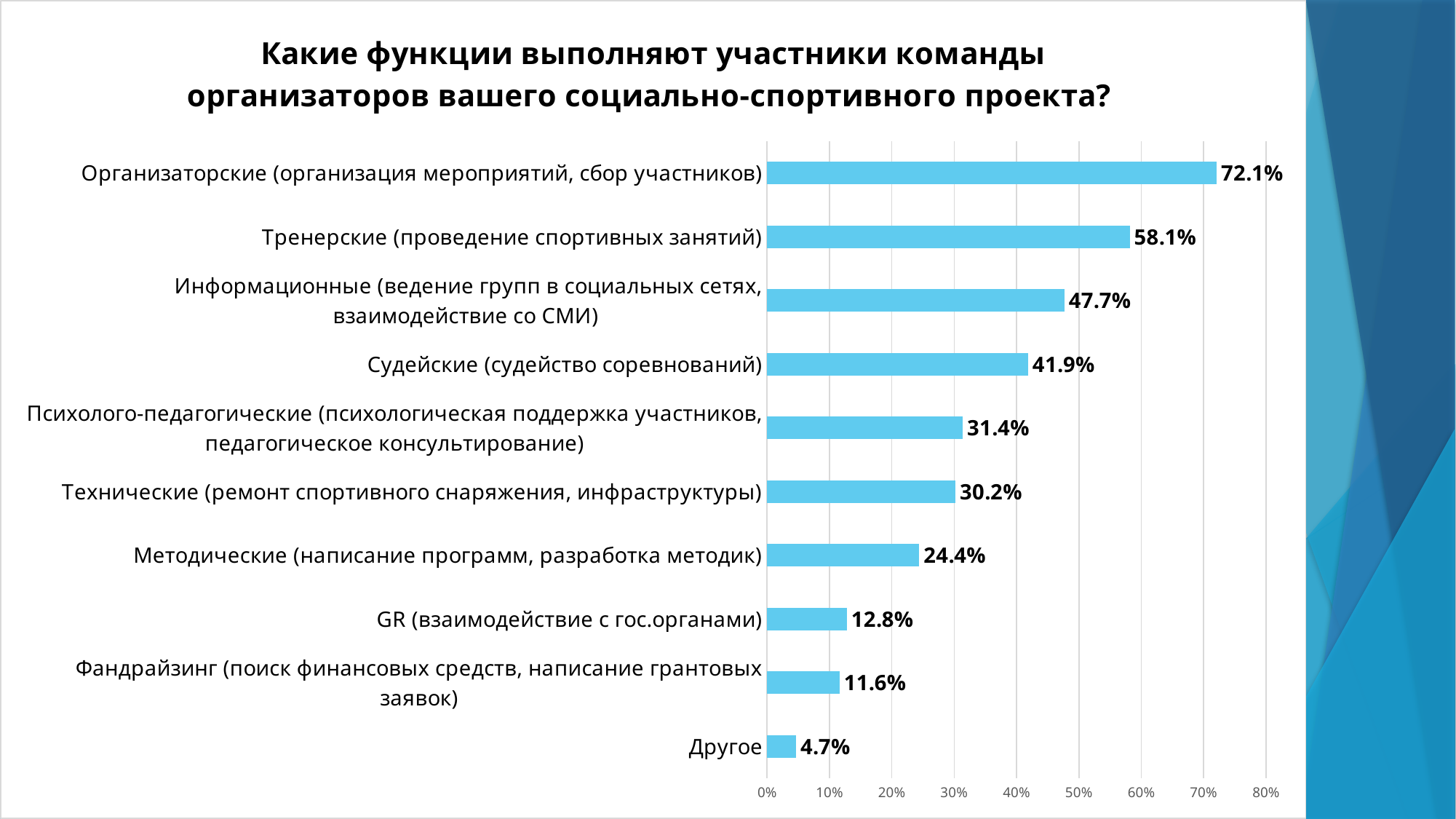
What is the difference between the values for Тренерские (проведение спортивных занятий) and Информационные (ведение групп в социальных сетях, взаимодействие со СМИ)? 10.4% What is the value for Судейские (судейство соревнований)? 41.9% What is the difference between the values for Фандрайзинг (поиск финансовых средств, написание грантовых заявок) and Другое? 6.9% Is the value for Психолого-педагогические (психологическая поддержка участников, педагогическое консультирование) greater or less than 40%? less Which category has the lowest value? Другое How many categories are shown in the chart? 10 What kind of chart is shown on the slide? bar chart Which category has the highest value? Организаторские (организация мероприятий, сбор участников) Which is larger: the value for Методические (написание программ, разработка методик) or the value for Технические (ремонт спортивного снаряжения, инфраструктуры)? Технические (ремонт спортивного снаряжения, инфраструктуры) What is the value for Организаторские (организация мероприятий, сбор участников)? 72.1% What is the value for GR (взаимодействие с гос.органами)? 12.8% What is the title of the chart? Какие функции выполняют участники команды организаторов вашего социально-спортивного проекта?